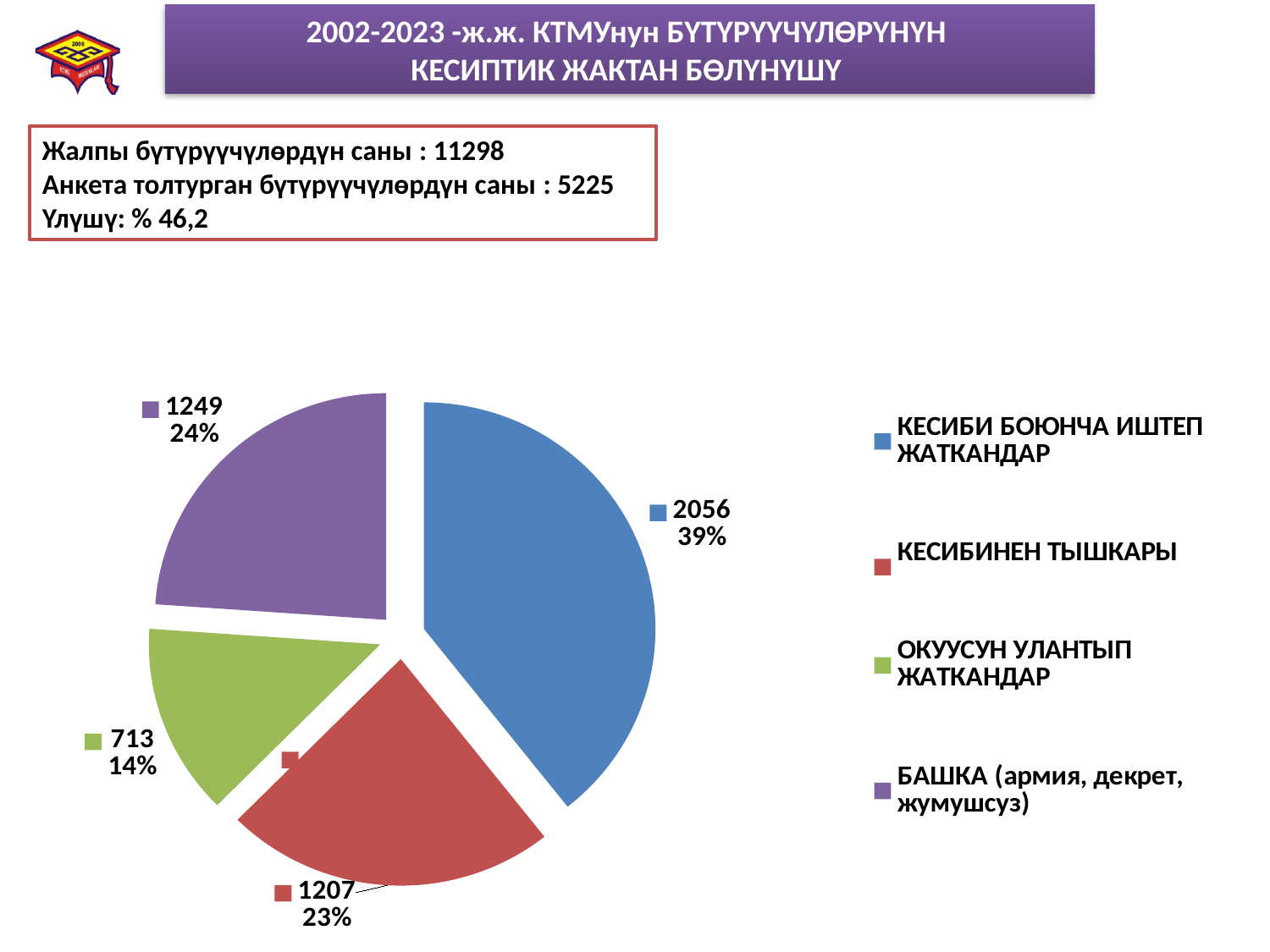
What share of the pie does КЕСИБИ БОЮНЧА ИШТЕП ЖАТКАНДАР represent? 39% How many slices does the pie chart have? 4 What share of the pie does ОКУУСУН УЛАНТЫП ЖАТКАНДАР represent? 14% Which category has the largest slice in the pie chart? КЕСИБИ БОЮНЧА ИШТЕП ЖАТКАНДАР What is the value for КЕСИБИ БОЮНЧА ИШТЕП ЖАТКАНДАР in the pie chart? 2056 How many entries does the legend of the pie chart list? 4 What is the value for БАШКА (армия, декрет, жумушсуз) in the pie chart? 1249 What is the value for ОКУУСУН УЛАНТЫП ЖАТКАНДАР in the pie chart? 713 What is the value for КЕСИБИНЕН ТЫШКАРЫ in the pie chart? 1207 Which category has the smallest slice in the pie chart? ОКУУСУН УЛАНТЫП ЖАТКАНДАР What is the difference between the values for КЕСИБИ БОЮНЧА ИШТЕП ЖАТКАНДАР and КЕСИБИНЕН ТЫШКАРЫ? 849 What type of chart is shown on the slide? pie chart